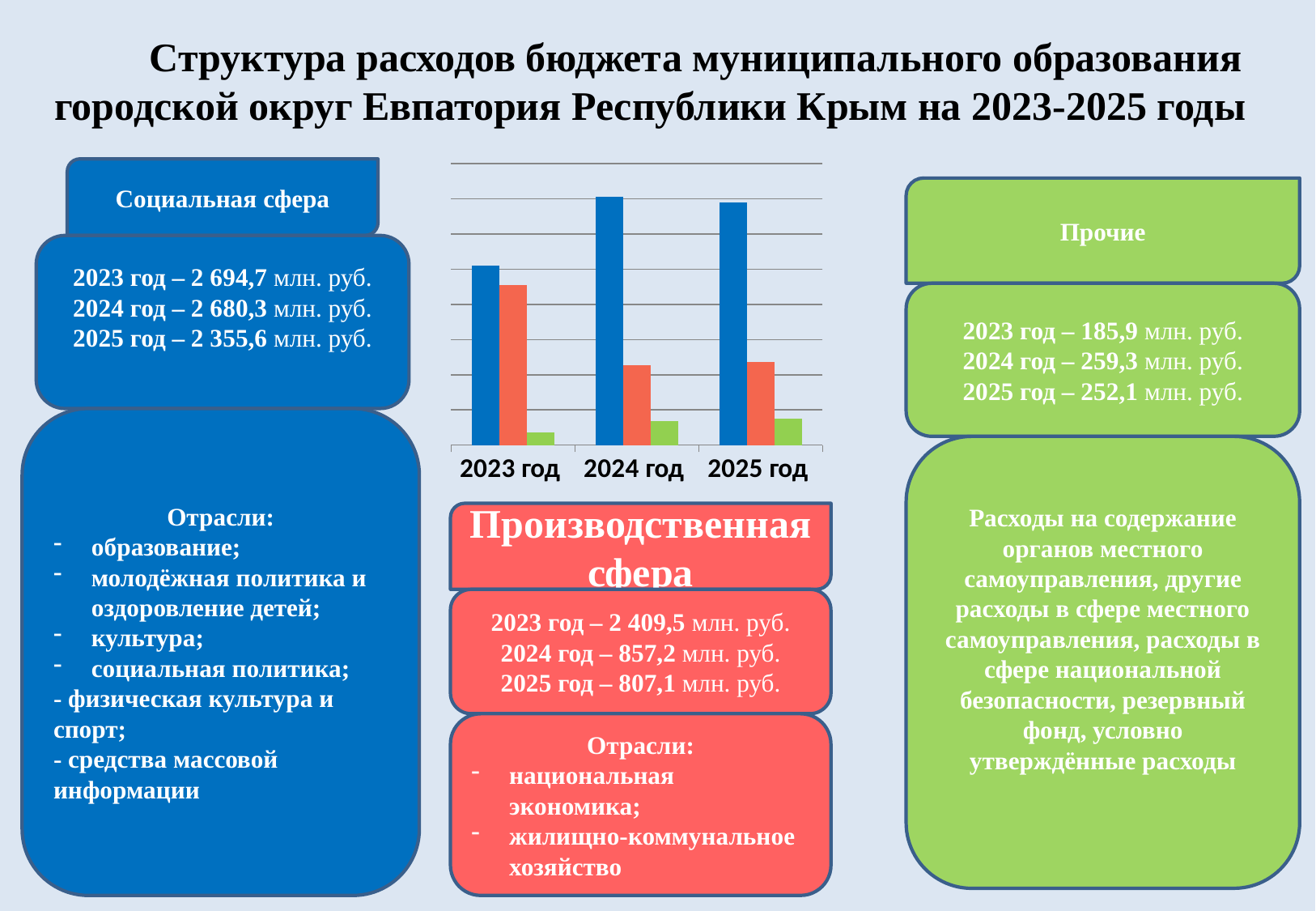
How many categories are shown on the x axis of the chart? 3 What are the category labels on the x axis of the chart? 2023 год, 2024 год, 2025 год In which year is the red bar the tallest? 2023 год For 2023 год, which bar is taller, the blue one or the red one? blue For 2024 год, which bar is taller, the red one or the green one? red Do the red bars rise or fall from 2023 год to 2025 год? fall In which year is the green bar the shortest? 2023 год How many bars are plotted for each year in the chart? 3 What kind of chart is shown on the slide? bar chart In which year is the blue bar the shortest? 2023 год In which year is the blue bar the tallest? 2024 год Does the chart display a legend? No